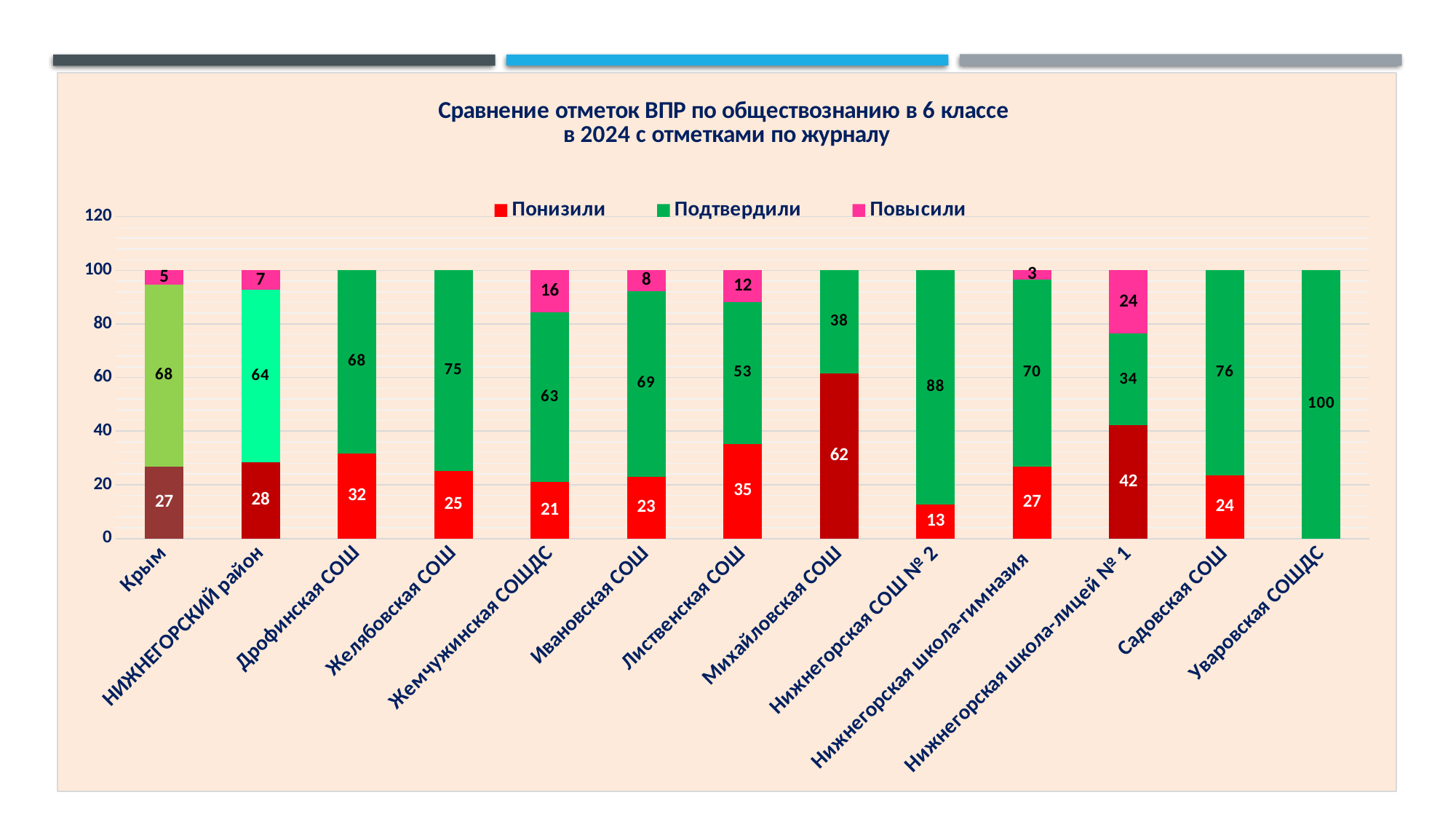
Which category has the lowest value for Подтвердили? Нижнегорская школа-лицей № 1 What is the difference between the Понизили values for Михайловская СОШ and Лиственская СОШ? 27 How many series does the legend list? 3 What is the value of Понизили for Михайловская СОШ? 62 Which has a larger Подтвердили value, Дрофинская СОШ or Желябовская СОШ? Желябовская СОШ How many categories are shown on the x axis? 13 What is the total of the stacked bar for Крым? 100 Which category has the highest value for Подтвердили? Уваровская СОШДС What kind of chart is shown on the slide? Stacked bar chart Which category has the highest value for Понизили? Михайловская СОШ What is the value of Повысили for Жемчужинская СОШДС? 16 What is the value of Повысили for Нижнегорская школа-лицей № 1? 24